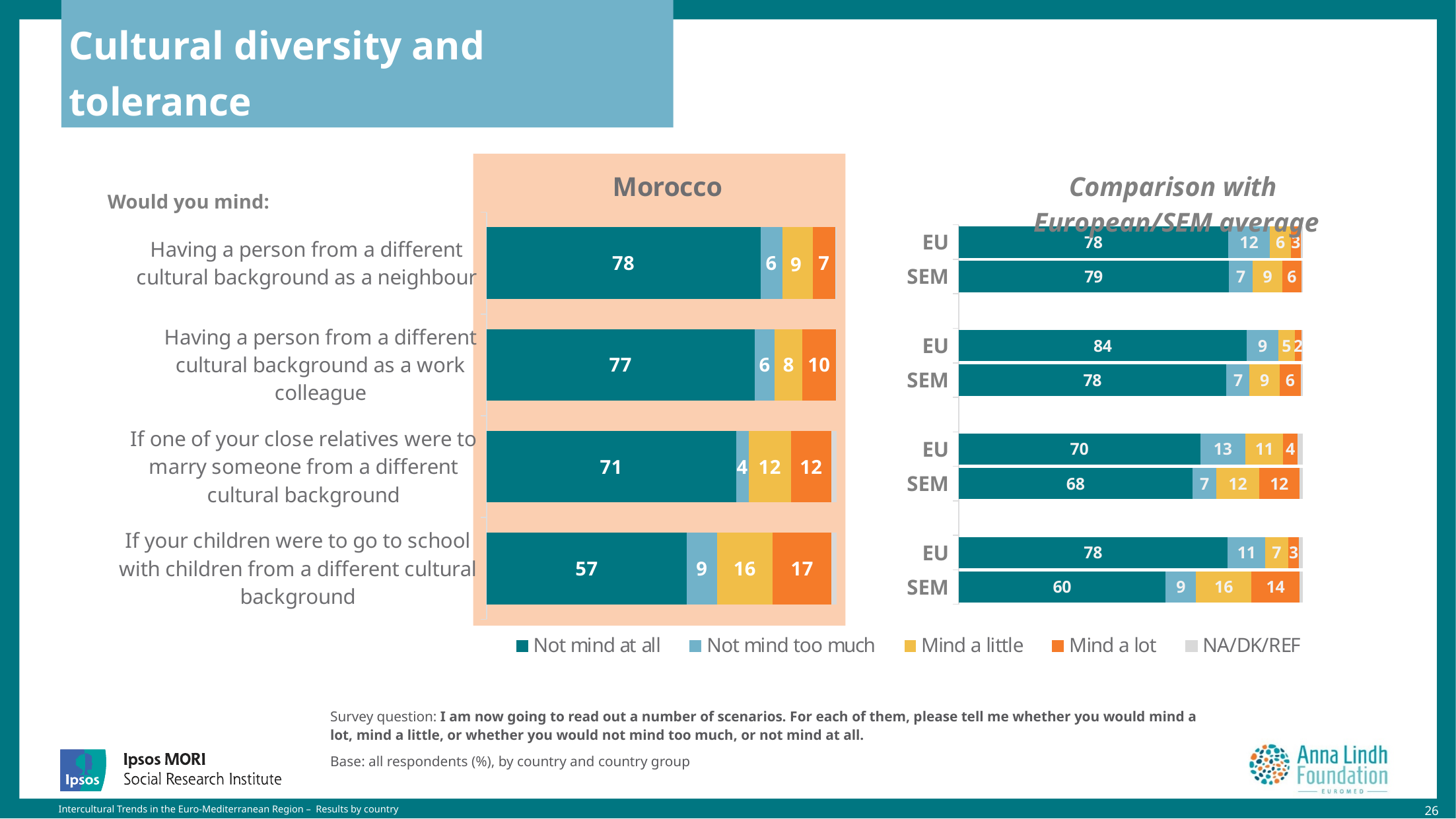
How many scenarios are plotted in the Morocco chart? 4 What kind of chart is the Morocco chart? Stacked bar chart How many series does the legend list? 5 In the Morocco chart, which has the larger 'Mind a little' value: the close relative marrying scenario or the work colleague scenario? The close relative marrying scenario In the Comparison with European/SEM average chart, what is the EU 'Not mind at all' value for having a person from a different cultural background as a work colleague? 84 In the Morocco chart, which scenario has the lowest 'Not mind at all' value? If your children were to go to school with children from a different cultural background In the Morocco chart, what percentage would not mind at all having a person from a different cultural background as a neighbour? 78 In the Morocco chart, what is the 'Mind a lot' value for children going to school with children from a different cultural background? 17 In the Comparison with European/SEM average chart, what is the SEM 'Mind a lot' value for the school scenario? 14 In the Comparison with European/SEM average chart, which EU bar has the highest 'Not mind at all' value? Having a person from a different cultural background as a work colleague In the Morocco chart, what is the difference between the 'Not mind at all' values for the neighbour scenario and the school scenario? 21 In the Comparison with European/SEM average chart, what is the difference between the EU and SEM 'Not mind at all' values for the school scenario? 18